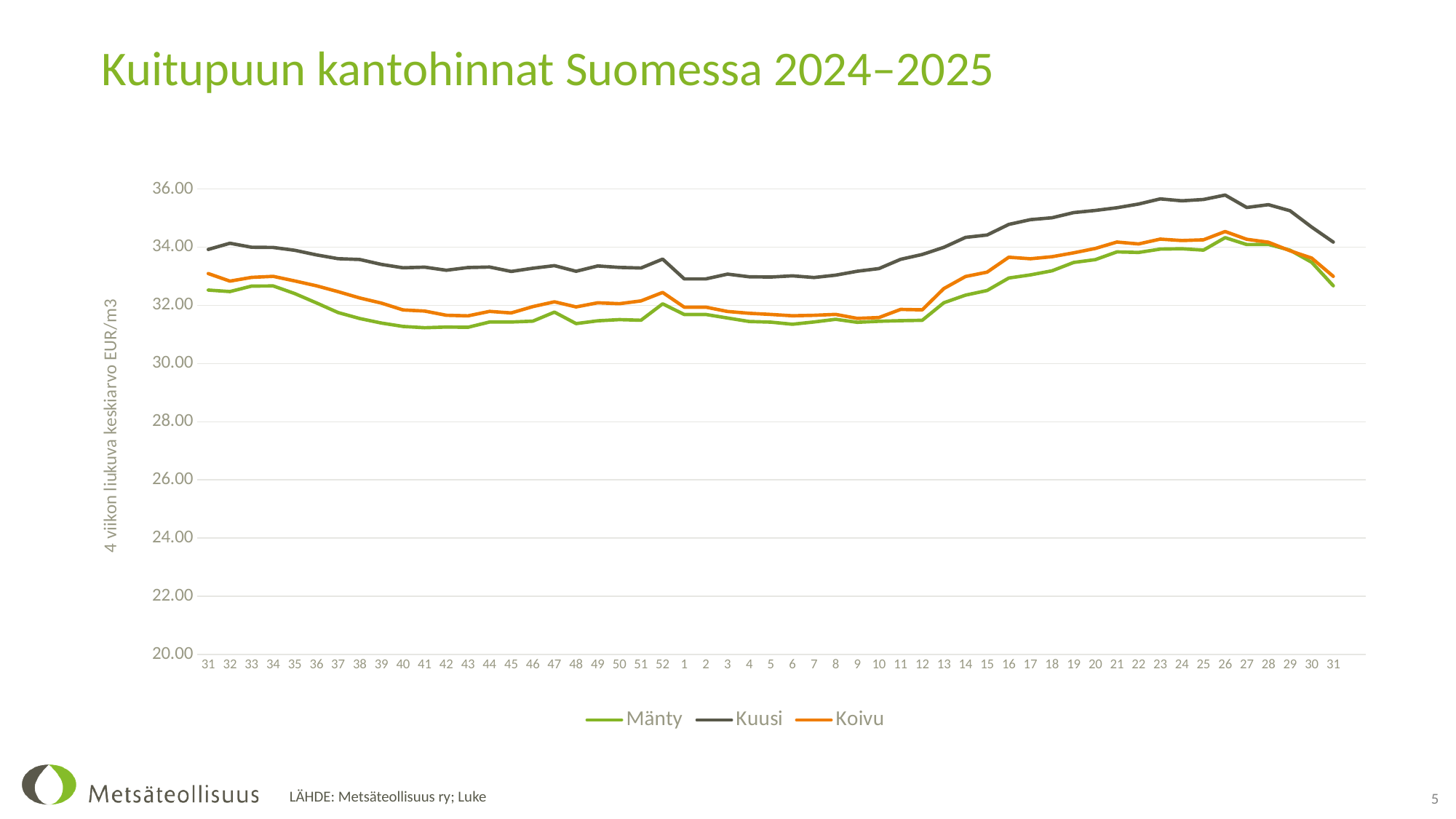
How many week labels are shown on the x axis? 53 Which series has the lowest value at week 40? Mänty Is the value for Kuusi at week 26 greater or less than 34.00? greater Which series are listed in the legend? Mänty, Kuusi, Koivu Which series has the highest value at week 26? Kuusi What is the title of the chart? Kuitupuun kantohinnat Suomessa 2024–2025 At week 31 (the first point), which is higher, Kuusi or Mänty? Kuusi How many series does the legend list? 3 Is the value for Mänty at week 40 greater or less than 32.00? less Is the value for Kuusi at week 1 greater or less than 34.00? less Does the Kuusi line rise or fall from week 12 to week 26? Rise What kind of chart is shown on the slide? Line chart